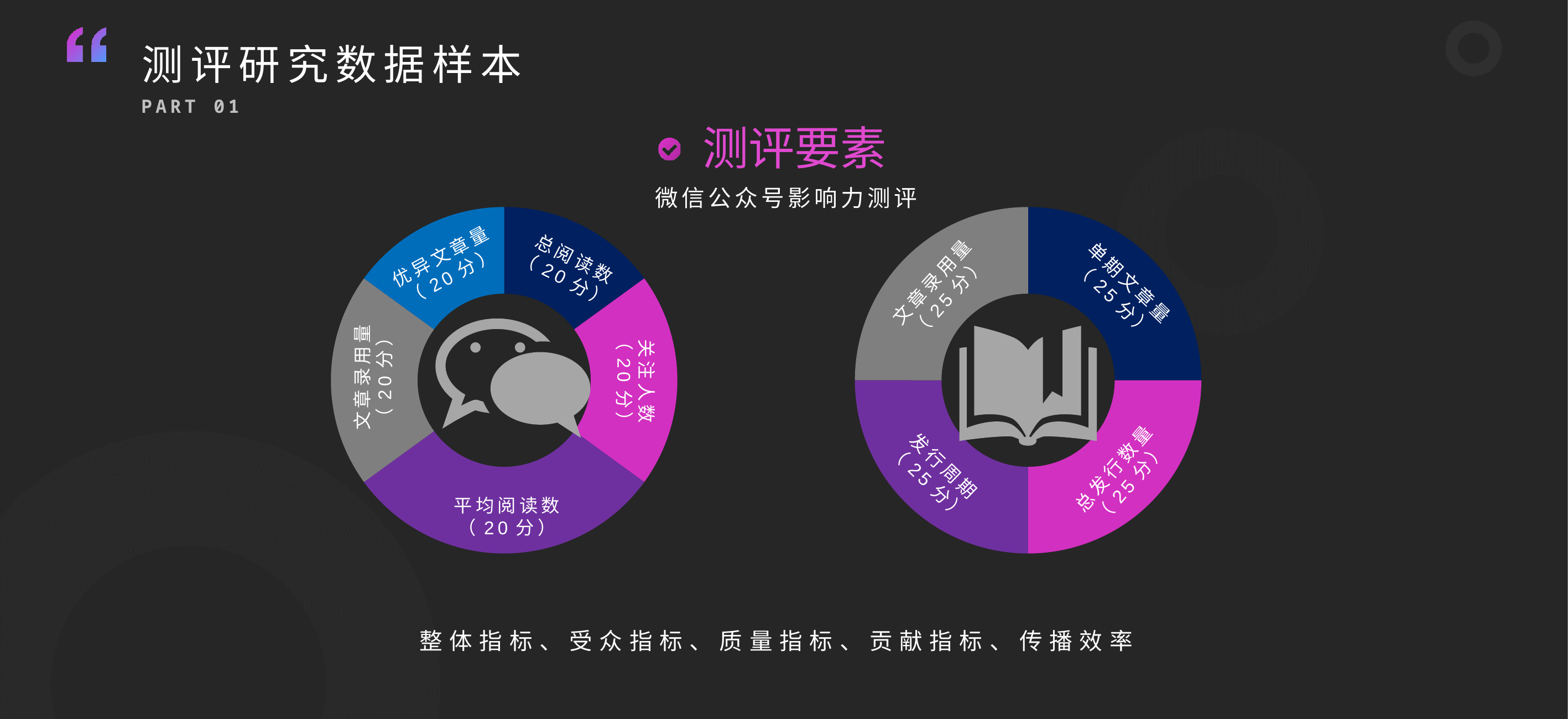
What kind of chart is the left chart on the slide? Donut (pie) chart What is the total of all segment scores in the right donut chart? 100分 On the right donut chart, how many points is 单期文章量 worth? 25分 On the left donut chart, how many points is 平均阅读数 worth? 20分 On the left donut chart, what colour is the 关注人数 segment? Magenta On the left donut chart, how many points is 关注人数 worth? 20分 How many segments does the right donut chart have? 4 On the right donut chart, what share of the total does 总发行数量 represent? 25% How many segments does the left donut chart have? 5 On the left donut chart, how many points is 总阅读数 worth? 20分 What is the total of all segment scores in the left donut chart? 100分 On the right donut chart, how many points is 发行周期 worth? 25分